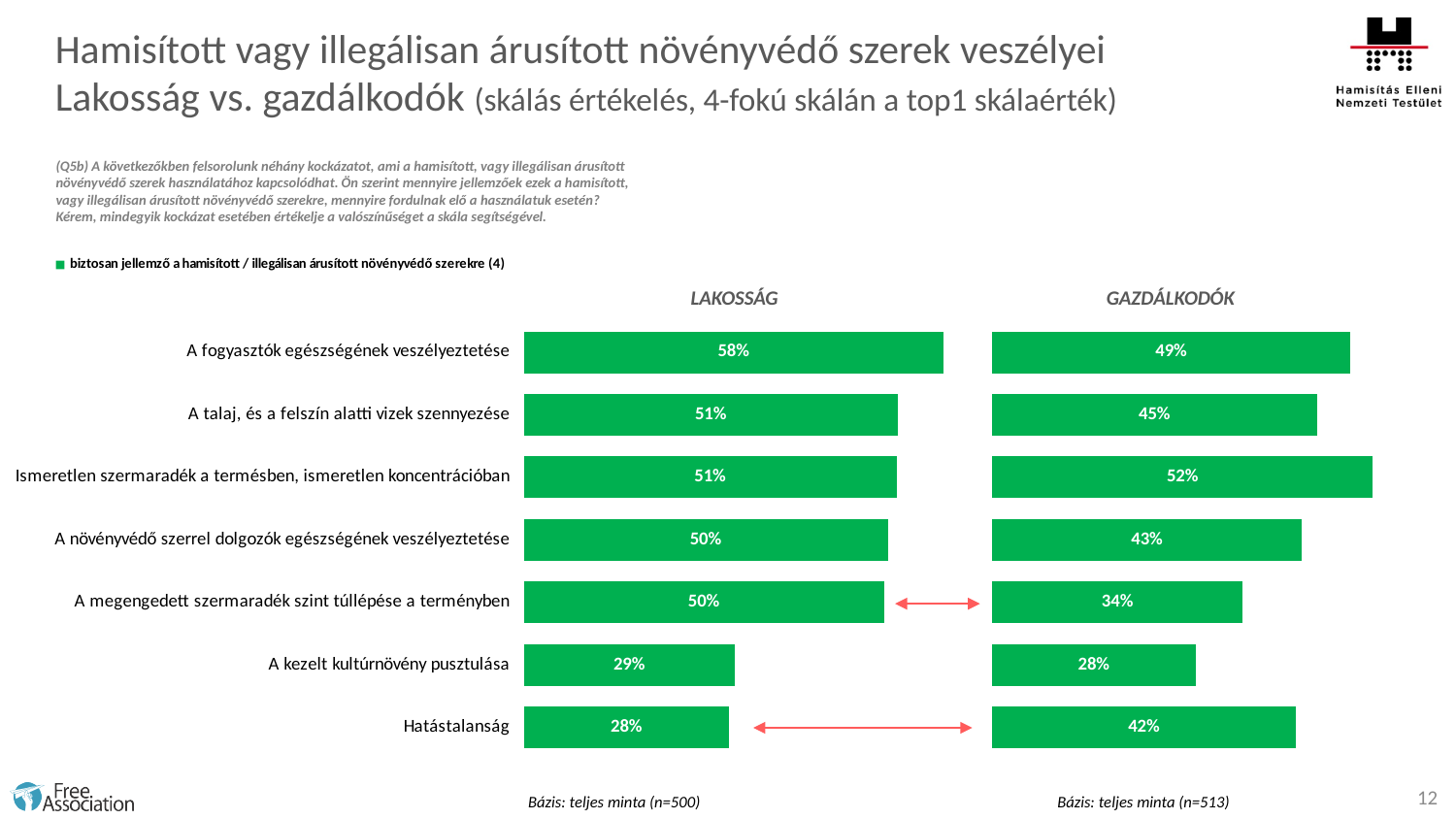
In the GAZDÁLKODÓK chart, which category has the highest value? Ismeretlen szermaradék a termésben, ismeretlen koncentrációban What is the sample size (n) stated under the GAZDÁLKODÓK chart? n=513 In the GAZDÁLKODÓK chart, what is the value for "Hatástalanság"? 42% What kind of chart is used on this slide? Bar chart What is the difference between the LAKOSSÁG and GAZDÁLKODÓK values for "A fogyasztók egészségének veszélyeztetése"? 9 percentage points What is the difference between the LAKOSSÁG and GAZDÁLKODÓK values for "A megengedett szermaradék szint túllépése a terményben"? 16 percentage points In the LAKOSSÁG chart, what is the value for "A fogyasztók egészségének veszélyeztetése"? 58% In the LAKOSSÁG chart, which category has the highest value? A fogyasztók egészségének veszélyeztetése For "Hatástalanság", which is larger: the LAKOSSÁG value or the GAZDÁLKODÓK value? GAZDÁLKODÓK How many categories are shown in the LAKOSSÁG chart? 7 In the GAZDÁLKODÓK chart, which category has the lowest value? A kezelt kultúrnövény pusztulása In the GAZDÁLKODÓK chart, what is the value for "A megengedett szermaradék szint túllépése a terményben"? 34%